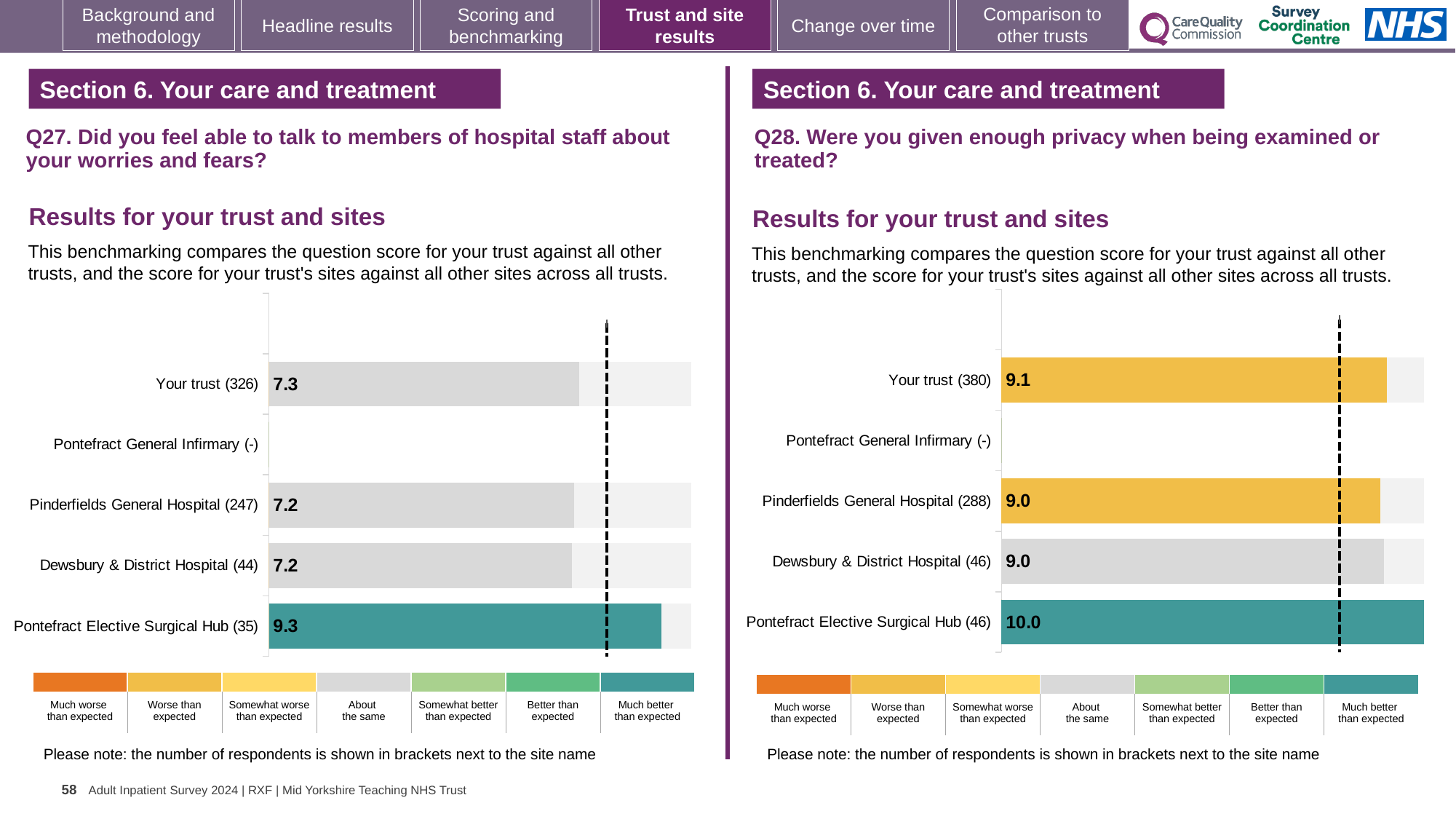
In the Q28 chart on the right, which benchmark category does the colour of the Your trust (380) bar represent according to the legend? Worse than expected In the Q28 chart on the right, what is the difference between the score for Pontefract Elective Surgical Hub (46) and the score for Your trust (380)? 0.9 In the Q28 chart on the right, what is the score for Dewsbury & District Hospital (46)? 9.0 In the Q27 chart on the left, what is the score for Your trust (326)? 7.3 In the Q28 chart on the right, which is larger: the score for Your trust (380) or the score for Pinderfields General Hospital (288)? Your trust (380) What type of chart is used in the Q27 chart on the left? Bar chart In the Q27 chart on the left, how many site or trust labels are listed on the vertical axis? 5 In the Q28 chart on the right, which site has the highest score? Pontefract Elective Surgical Hub (46) In the Q27 chart on the left, what is the score for Pontefract Elective Surgical Hub (35)? 9.3 In the Q28 chart on the right, what is the score for Your trust (380)? 9.1 In the Q27 chart on the left, what is the difference between the score for Pontefract Elective Surgical Hub (35) and the score for Pinderfields General Hospital (247)? 2.1 In the Q27 chart on the left, which site has the highest score? Pontefract Elective Surgical Hub (35)